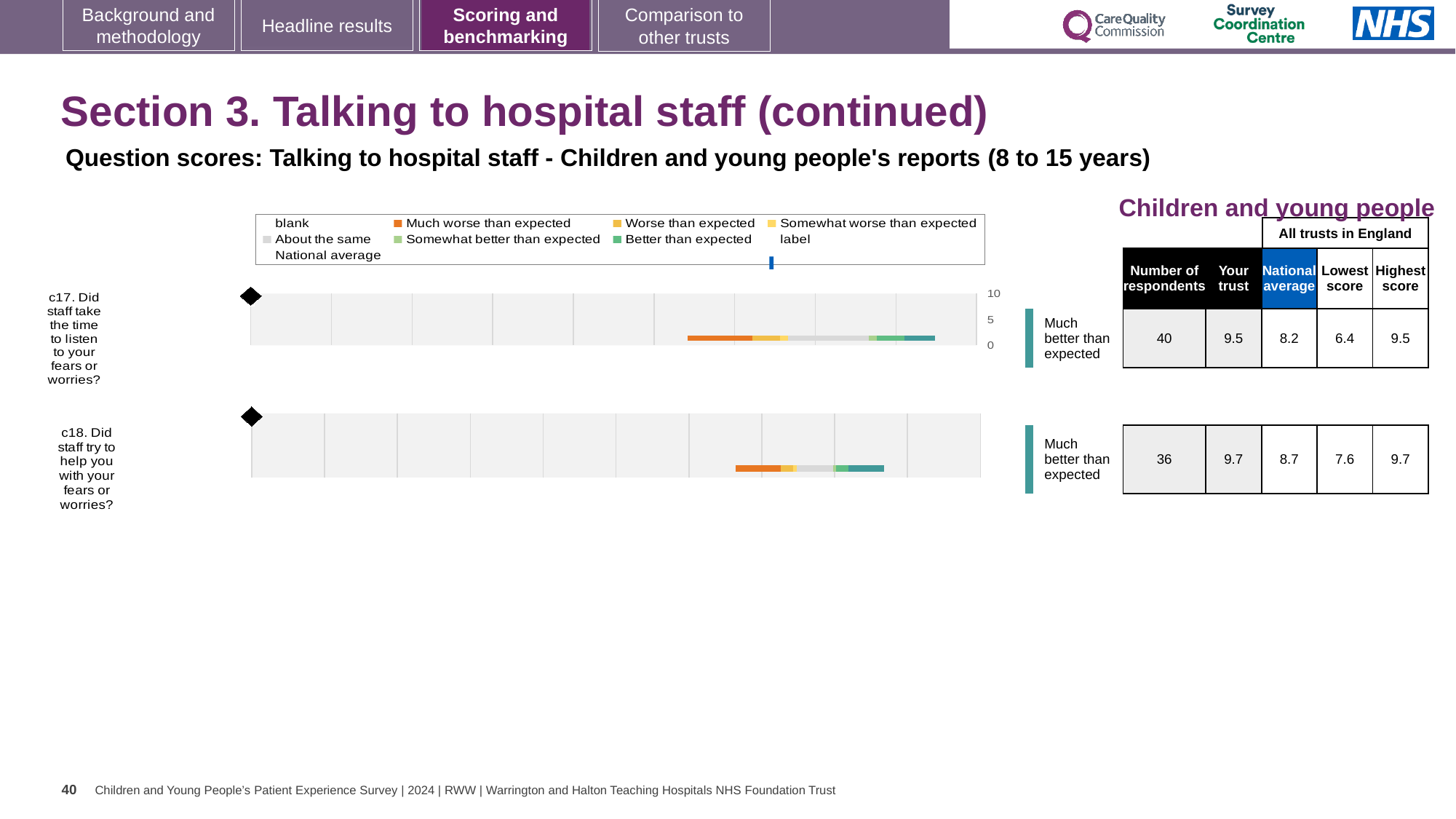
What is the difference between the 'Your trust' score and the national average for c18? 1.0 Which question has the higher national average, c17 or c18? c18 What is the 'Your trust' score for c18 (Did staff try to help you with your fears or worries?)? 9.7 What is the national average score for c17? 8.2 What is the lowest score among all trusts in England for c18? 7.6 How many respondents answered question c17? 40 How many questions are plotted on the slide? 2 What is the national average score for c18? 8.7 What benchmark category is shown next to the c17 chart? Much better than expected Which question has the higher 'Your trust' score, c17 or c18? c18 What is the 'Your trust' score for c17 (Did staff take the time to listen to your fears or worries?)? 9.5 What kind of chart is used to show the question scores for c17 and c18? bar chart